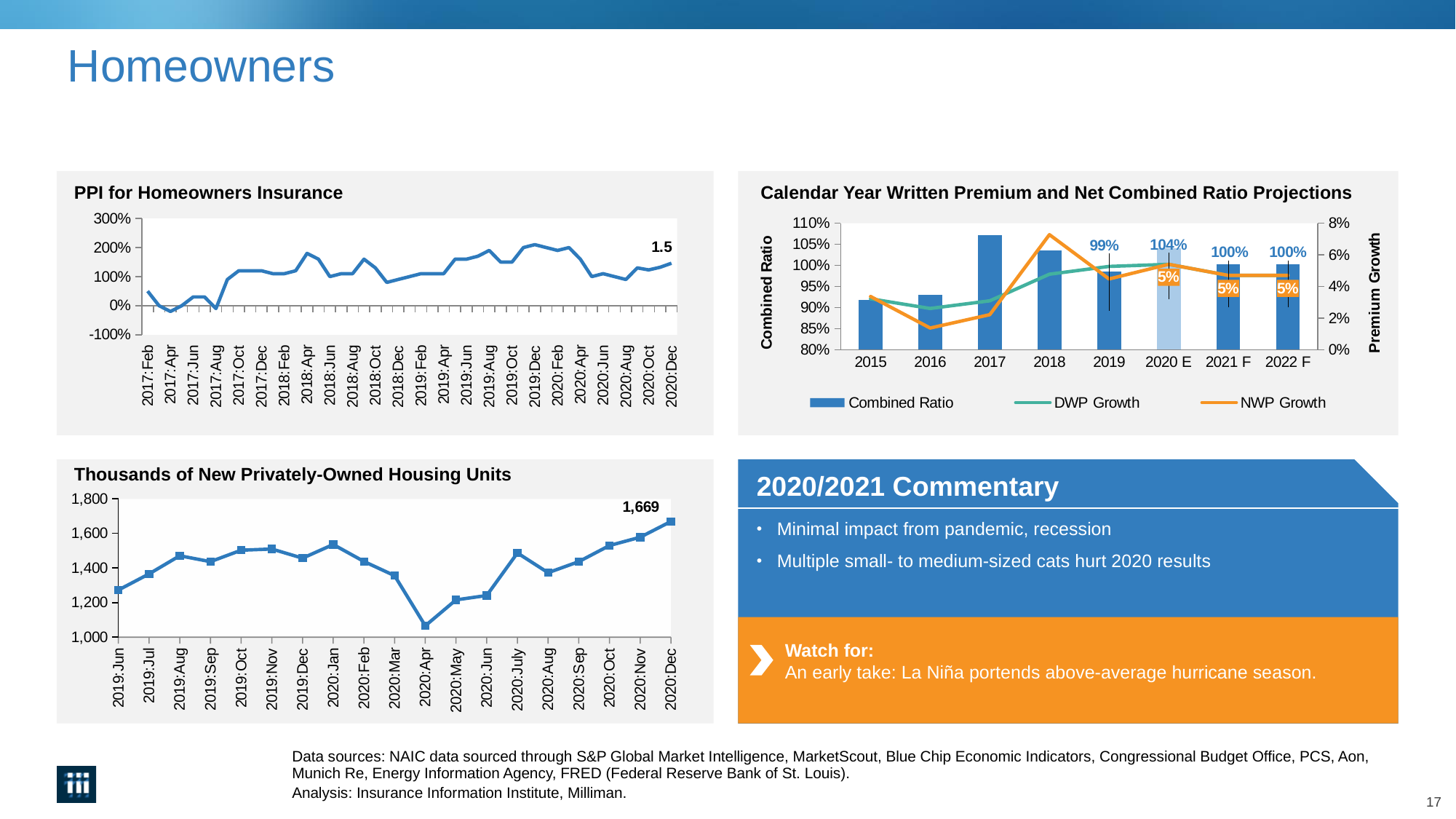
In the 'Calendar Year Written Premium and Net Combined Ratio Projections' chart, what is the combined ratio labeled for 2020 E? 104% In the 'Calendar Year Written Premium and Net Combined Ratio Projections' chart, is the combined ratio for 2016 greater or less than 95%? less In the 'Calendar Year Written Premium and Net Combined Ratio Projections' chart, what NWP Growth value is labeled for 2021 F? 5% In the 'Thousands of New Privately-Owned Housing Units' chart, is the value for 2020:Apr greater or less than 1,200? less In the 'Thousands of New Privately-Owned Housing Units' chart, which month has the lowest value? 2020:Apr In the 'Thousands of New Privately-Owned Housing Units' chart, what value is labeled for 2020:Dec? 1,669 In the 'Thousands of New Privately-Owned Housing Units' chart, which is larger, the value for 2019:Jun or the value for 2020:Dec? 2020:Dec In the 'Calendar Year Written Premium and Net Combined Ratio Projections' chart, how many years are shown on the x axis? 8 In the 'Calendar Year Written Premium and Net Combined Ratio Projections' chart, which year has the highest combined ratio bar? 2017 In the 'Calendar Year Written Premium and Net Combined Ratio Projections' chart, what is the combined ratio labeled for 2019? 99% What value is labeled at the end of the 'PPI for Homeowners Insurance' line for 2020:Dec? 1.5 In the 'Calendar Year Written Premium and Net Combined Ratio Projections' chart, how many series does the legend list? 3